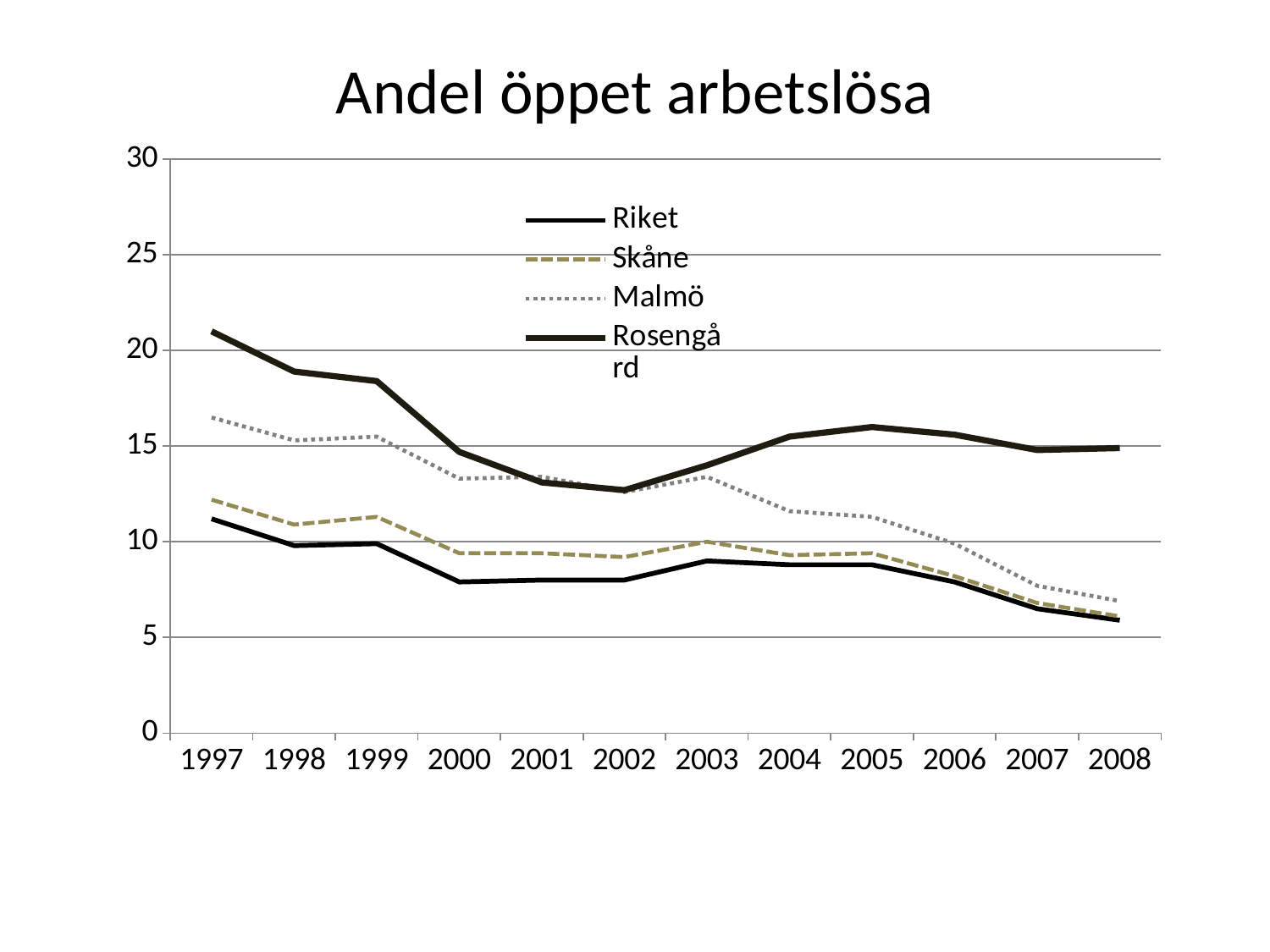
Is the value for Rosengård in 2002 greater or less than 15? less Does the Riket series rise or fall overall from 1997 to 2008? fall How many years are shown on the x axis? 12 Is the value for Malmö in 2008 greater or less than 10? less What is the title of the chart? Andel öppet arbetslösa Is the value for Rosengård in 1997 greater or less than 20? greater Which series has the highest value in 1997? Rosengård How many series does the legend list? 4 In which year does Rosengård reach its highest value? 1997 What kind of chart is shown on the slide? line chart Which is larger in 2004, the value for Rosengård or the value for Malmö? Rosengård Which series has the lowest value in 1997? Riket